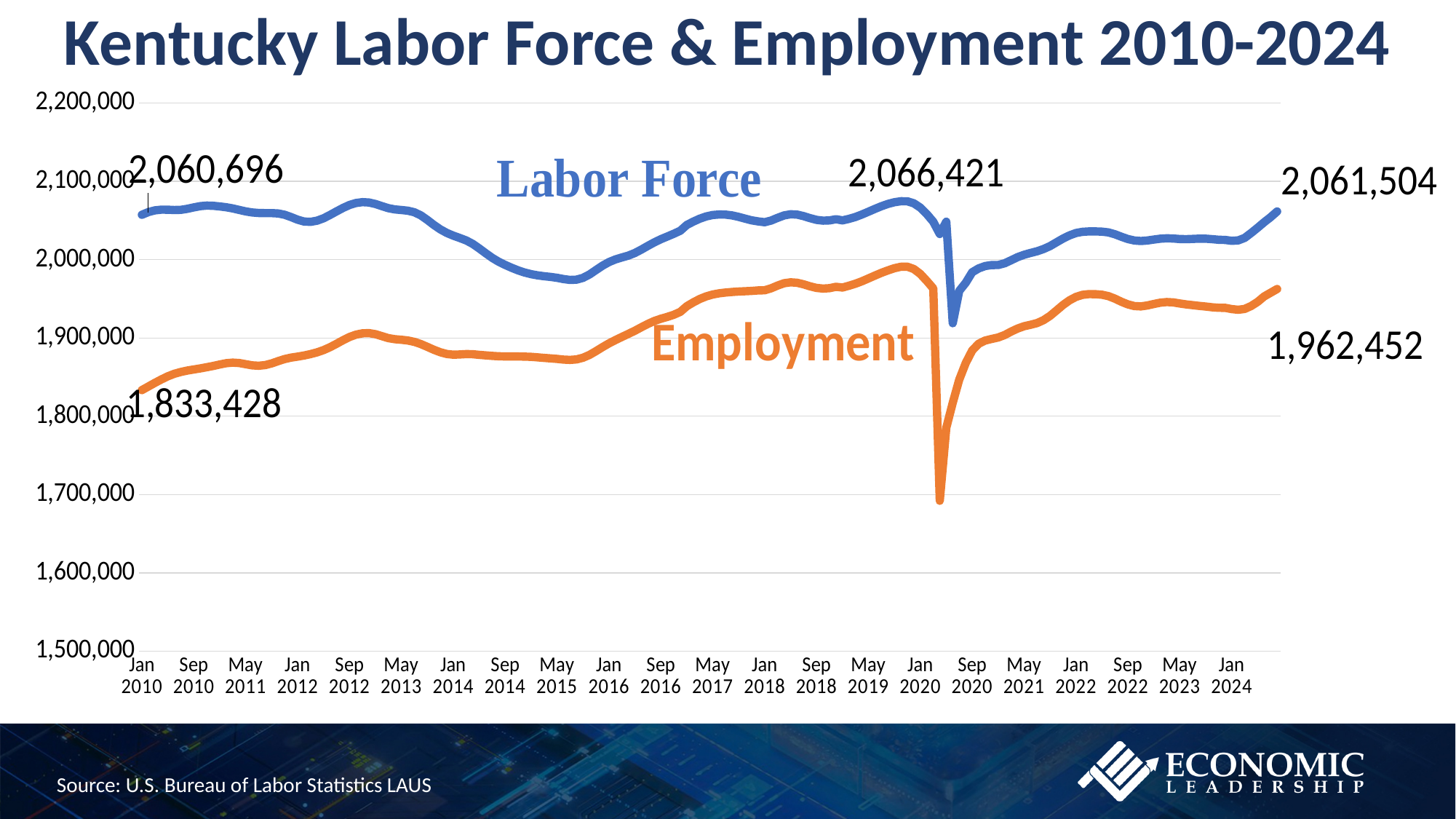
What is the Labor Force value labeled at the peak around Jan 2020? 2,066,421 What type of chart is shown on the slide? Line chart What is the Employment value labeled at the end of the series in 2024? 1,962,452 What was the Kentucky Employment value in Jan 2010? 1,833,428 What is the Labor Force value labeled at the end of the series in 2024? 2,061,504 How many data series are plotted on the chart? 2 Which series has higher values throughout the chart, Labor Force or Employment? Labor Force By how much did Employment increase from its Jan 2010 value to its labeled 2024 value? 129,024 Is the Labor Force value at its 2020 dip greater or less than 2,000,000? less Does Employment overall rise or fall from Jan 2010 to 2024? rise